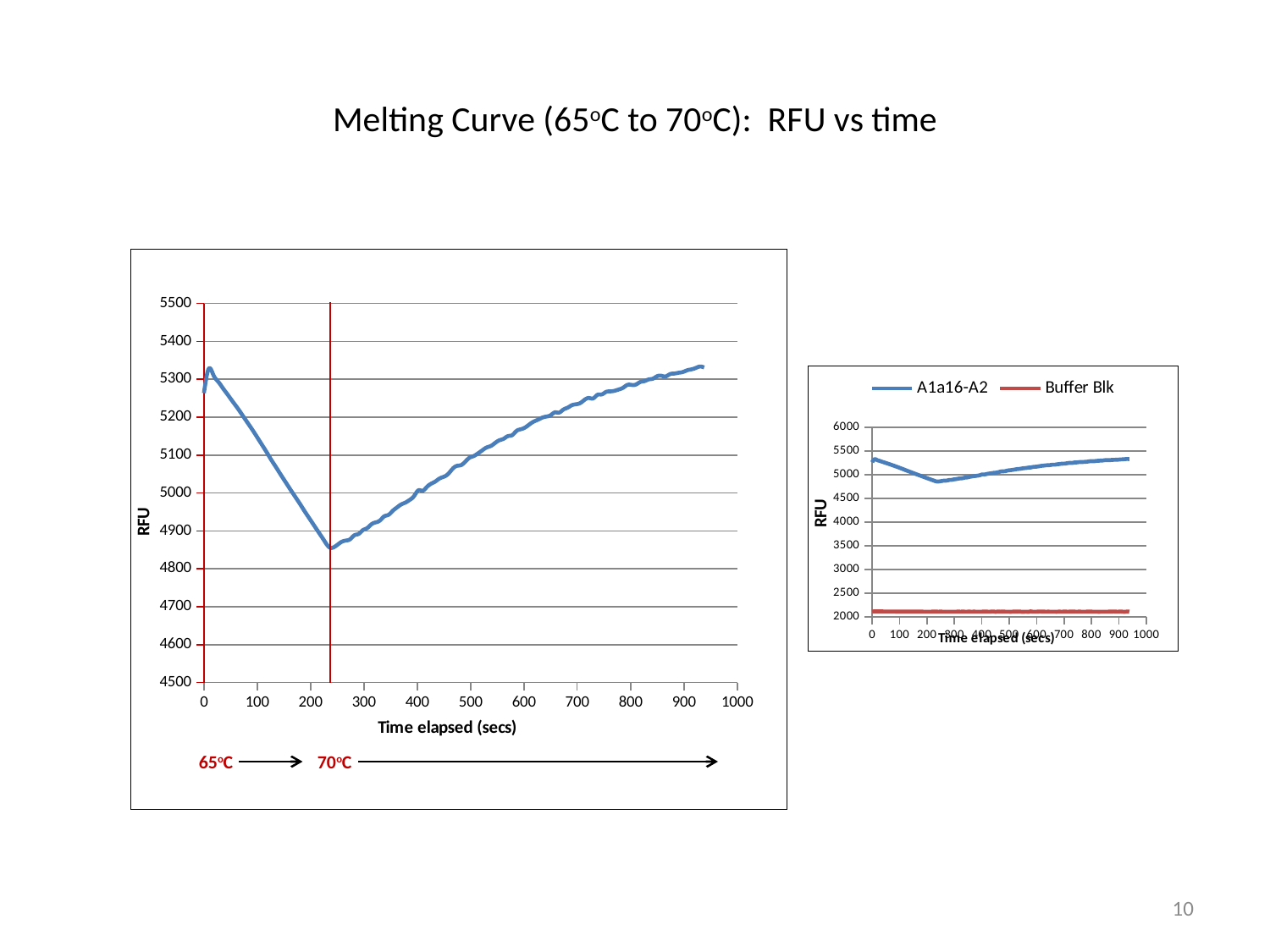
In the large chart on the left, do the RFU values rise or fall between 300 secs and 900 secs? rise What kind of chart is the large chart on the left of the slide? line chart In the large chart on the left, is the RFU value at 500 secs greater or less than 5000? greater What are the two series named in the legend of the small chart on the right? A1a16-A2 and Buffer Blk What is the x-axis title of the large chart on the left? Time elapsed (secs) How many series does the legend of the small chart on the right list? 2 In the small chart on the right, is the Buffer Blk series greater or less than 2500 RFU? less In the small chart on the right, is the A1a16-A2 value at 0 secs greater or less than 5000? greater In the large chart on the left, is the RFU value at 100 secs larger or smaller than the value at 300 secs? larger In the small chart on the right, which series has the higher RFU values, A1a16-A2 or Buffer Blk? A1a16-A2